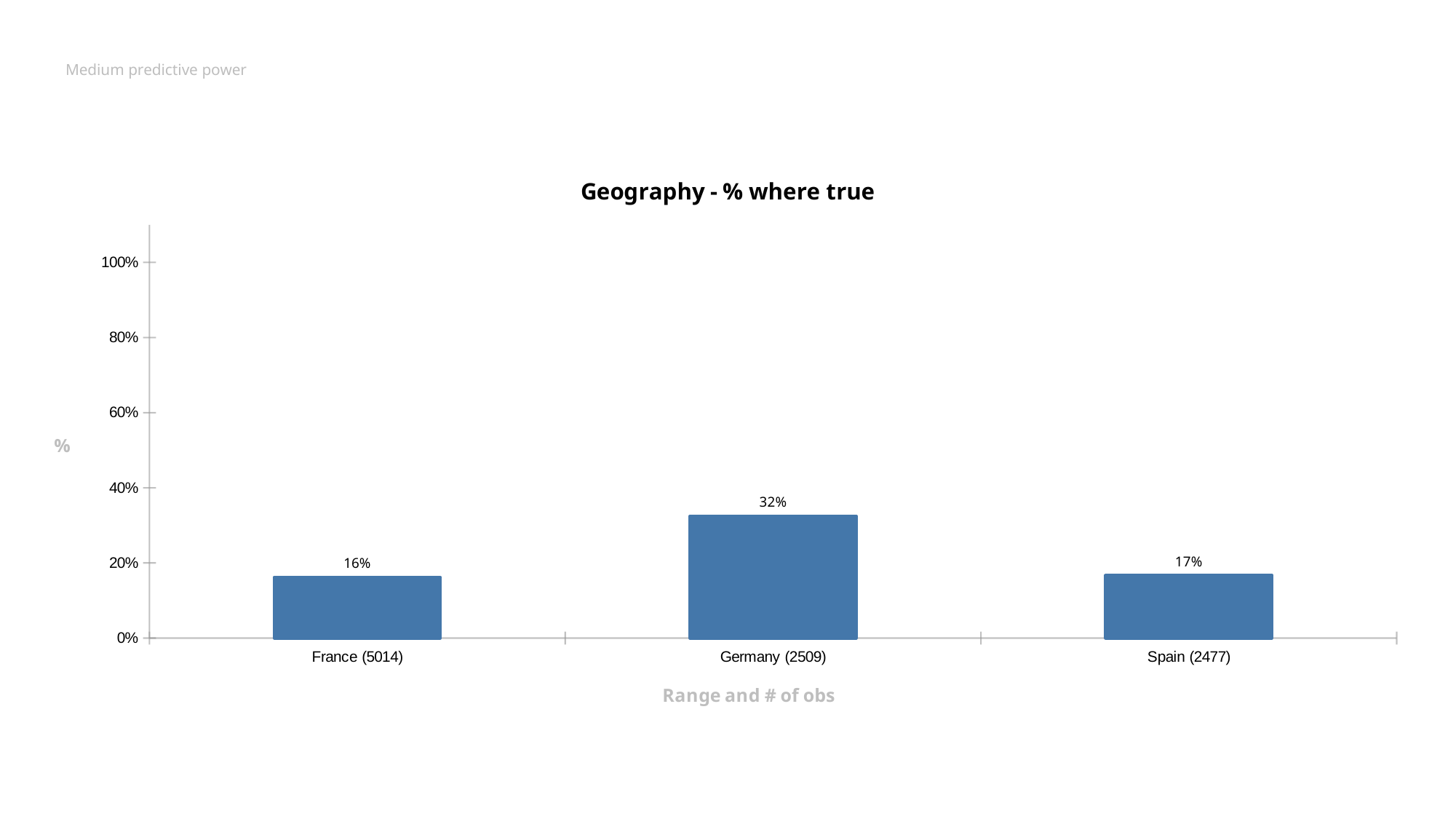
How many categories are shown on the x axis? 3 What kind of chart is shown on the slide? bar chart What is the value for Spain (2477)? 17% Which is larger, the value for Germany (2509) or the value for Spain (2477)? Germany (2509) Which category has the lowest value? France (5014) What is the difference between the values for Germany (2509) and France (5014)? 16% Is the value for Germany (2509) greater or less than 40%? less What is the value for Germany (2509)? 32% What is the difference between the values for Spain (2477) and France (5014)? 1% What is the title of the chart? Geography - % where true Which category has the highest value? Germany (2509) What is the value for France (5014)? 16%